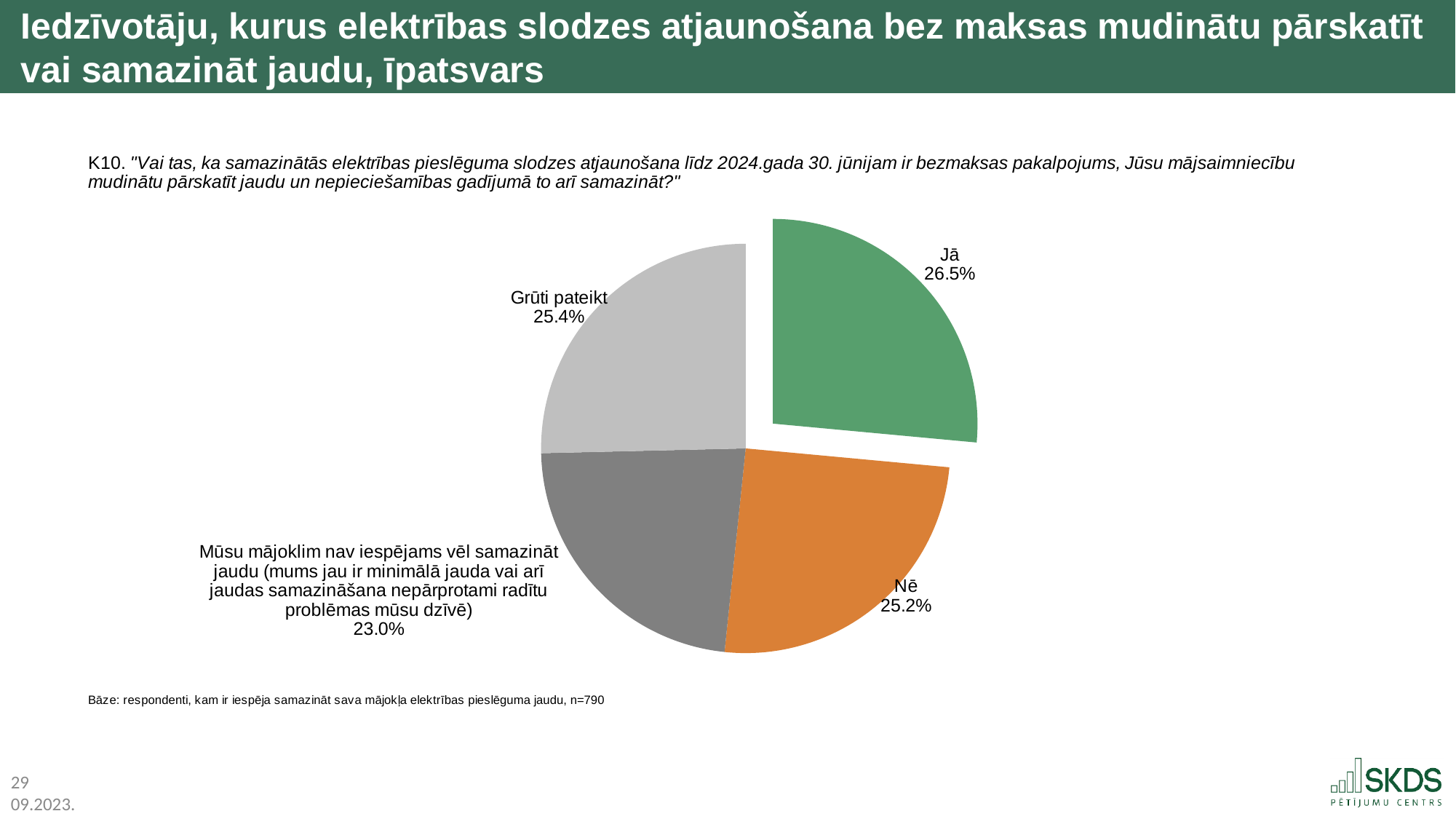
How many slices does the pie chart have? 4 What share of respondents answered "Nē"? 25.2% What kind of chart is shown on the slide? pie chart What is the base size (n) stated below the chart? n=790 What colour is the "Jā" slice? green Which answer option has the smallest share in the pie chart? Mūsu mājoklim nav iespējams vēl samazināt jaudu (mums jau ir minimālā jauda vai arī jaudas samazināšana nepārprotami radītu problēmas mūsu dzīvē) Which answer option has the largest share in the pie chart? Jā What share of respondents said their home cannot reduce capacity further ("Mūsu mājoklim nav iespējams vēl samazināt jaudu...")? 23.0% What is the difference in percentage points between the "Grūti pateikt" share and the share of those whose home cannot reduce capacity further? 2.4 percentage points What is the difference in percentage points between the "Jā" and "Nē" shares? 1.3 percentage points What share of respondents answered "Jā"? 26.5% What share of respondents answered "Grūti pateikt"? 25.4%